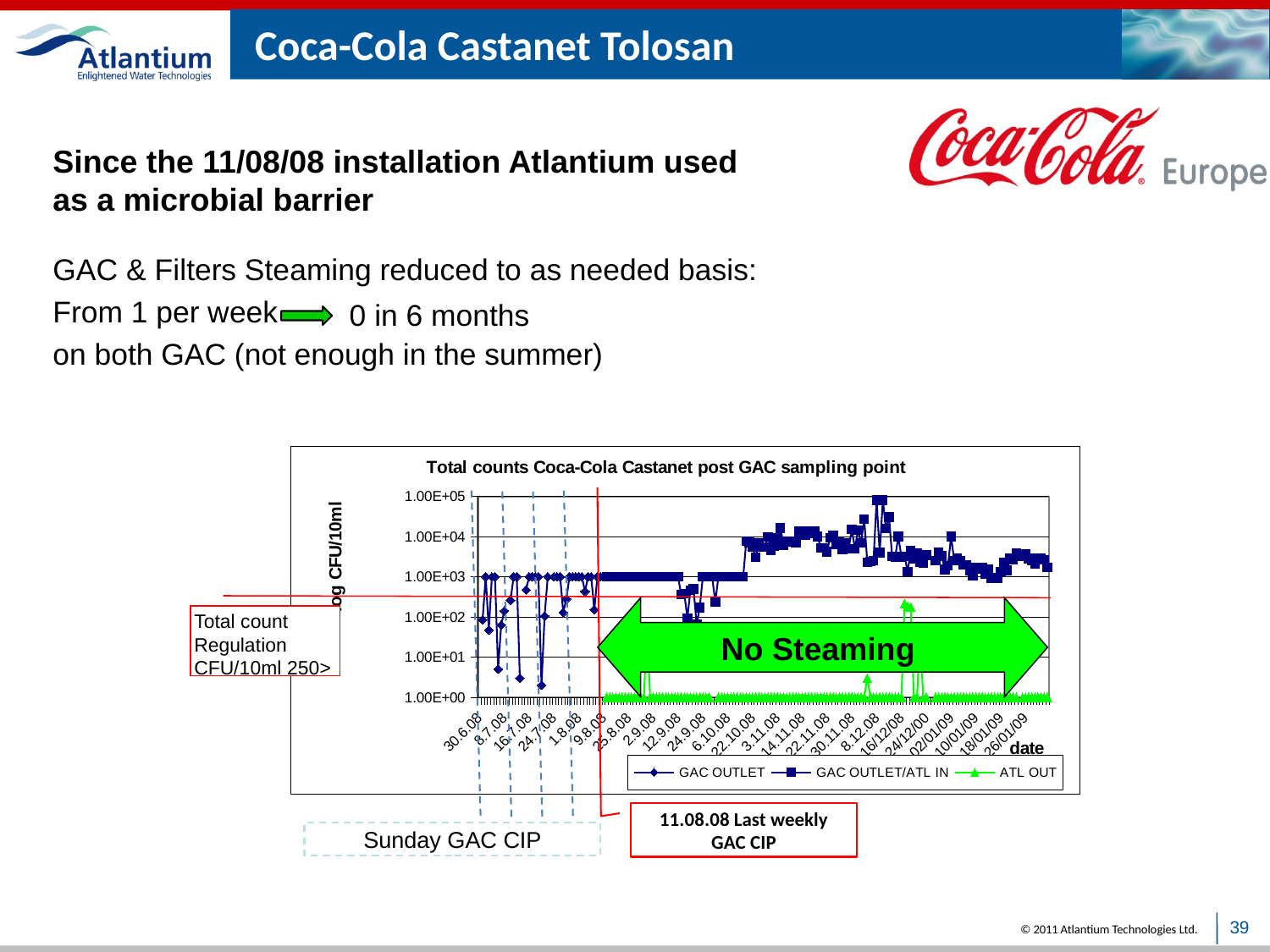
What is the lowest tick value shown on the y axis of the chart? 1.00E+00 Are the GAC OUTLET/ATL IN values around 8.12.08 greater or less than 1.00E+03? greater Which series is plotted with triangle markers in the chart? ATL OUT Which series has the lowest values across the chart, ATL OUT or GAC OUTLET/ATL IN? ATL OUT Are the ATL OUT values around 22.11.08 greater or less than 1.00E+01? less What is the title of the chart? Total counts Coca-Cola Castanet post GAC sampling point How many series does the chart legend list? 3 Do the GAC OUTLET/ATL IN values rise or fall between 9.8.08 and 8.12.08? rise What type of chart is shown on the slide? line chart